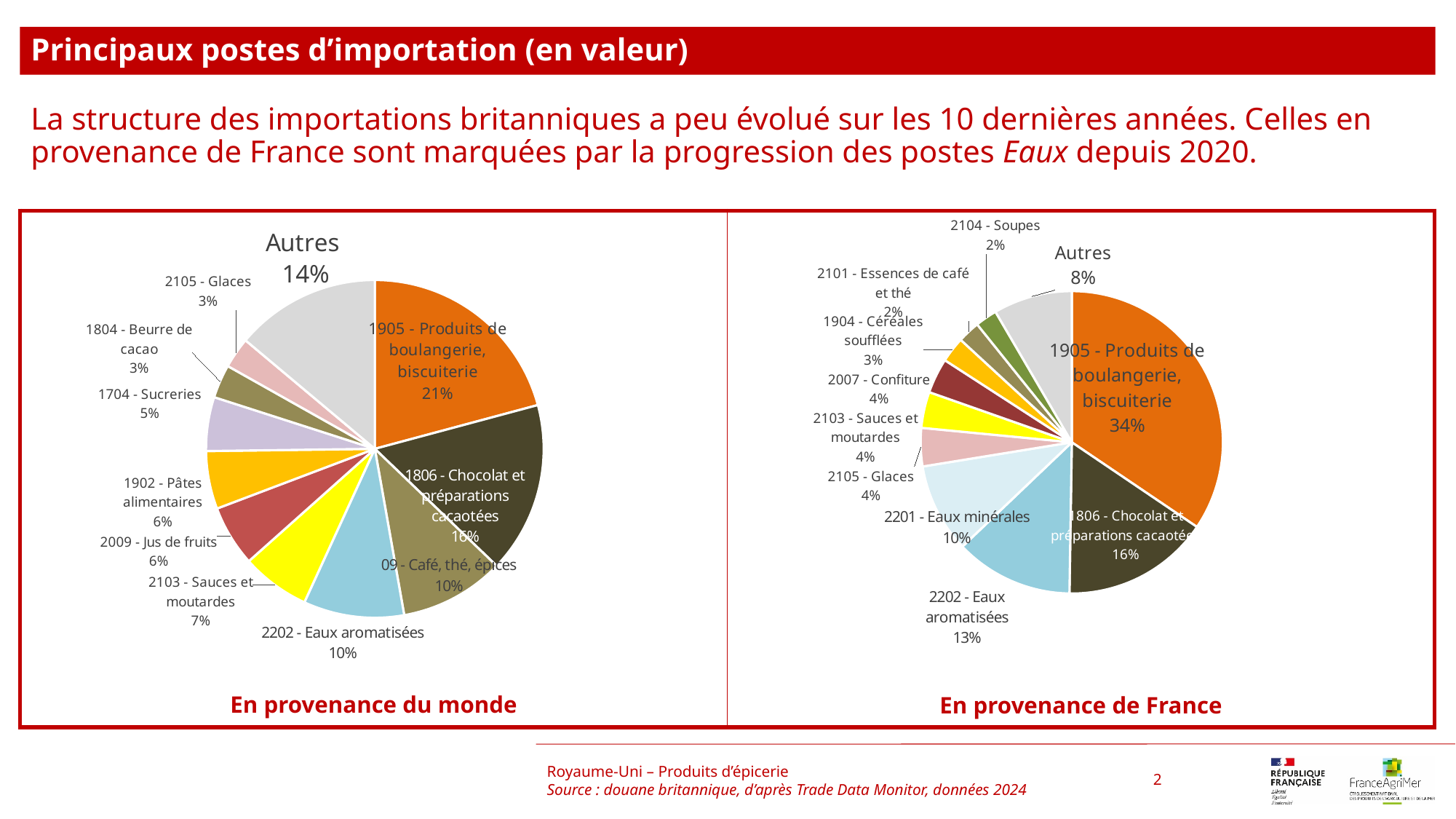
In the 'En provenance de France' chart, what is the share of Autres? 8% In the 'En provenance de France' chart, what is the difference between the share of 1905 - Produits de boulangerie, biscuiterie and 1806 - Chocolat et préparations cacaotées? 18 percentage points In the 'En provenance du monde' chart, which named category (excluding Autres) has the largest share? 1905 - Produits de boulangerie, biscuiterie In the 'En provenance de France' chart, what share do 1905 - Produits de boulangerie, biscuiterie represent? 34% In the 'En provenance du monde' chart, what is the share of 2103 - Sauces et moutardes? 7% In the 'En provenance de France' chart, what share do 2201 - Eaux minérales represent? 10% What is the title of the pie chart on the right side of the slide? En provenance de France What kind of charts are shown on the slide? Pie charts In the 'En provenance du monde' chart, what is the combined share of 2202 - Eaux aromatisées and 09 - Café, thé, épices? 20% In the 'En provenance du monde' chart, what share do 1905 - Produits de boulangerie, biscuiterie represent? 21% How many slices does the 'En provenance de France' pie chart have? 11 In the 'En provenance du monde' chart, which is larger: the share of 1704 - Sucreries or the share of 2009 - Jus de fruits? 2009 - Jus de fruits